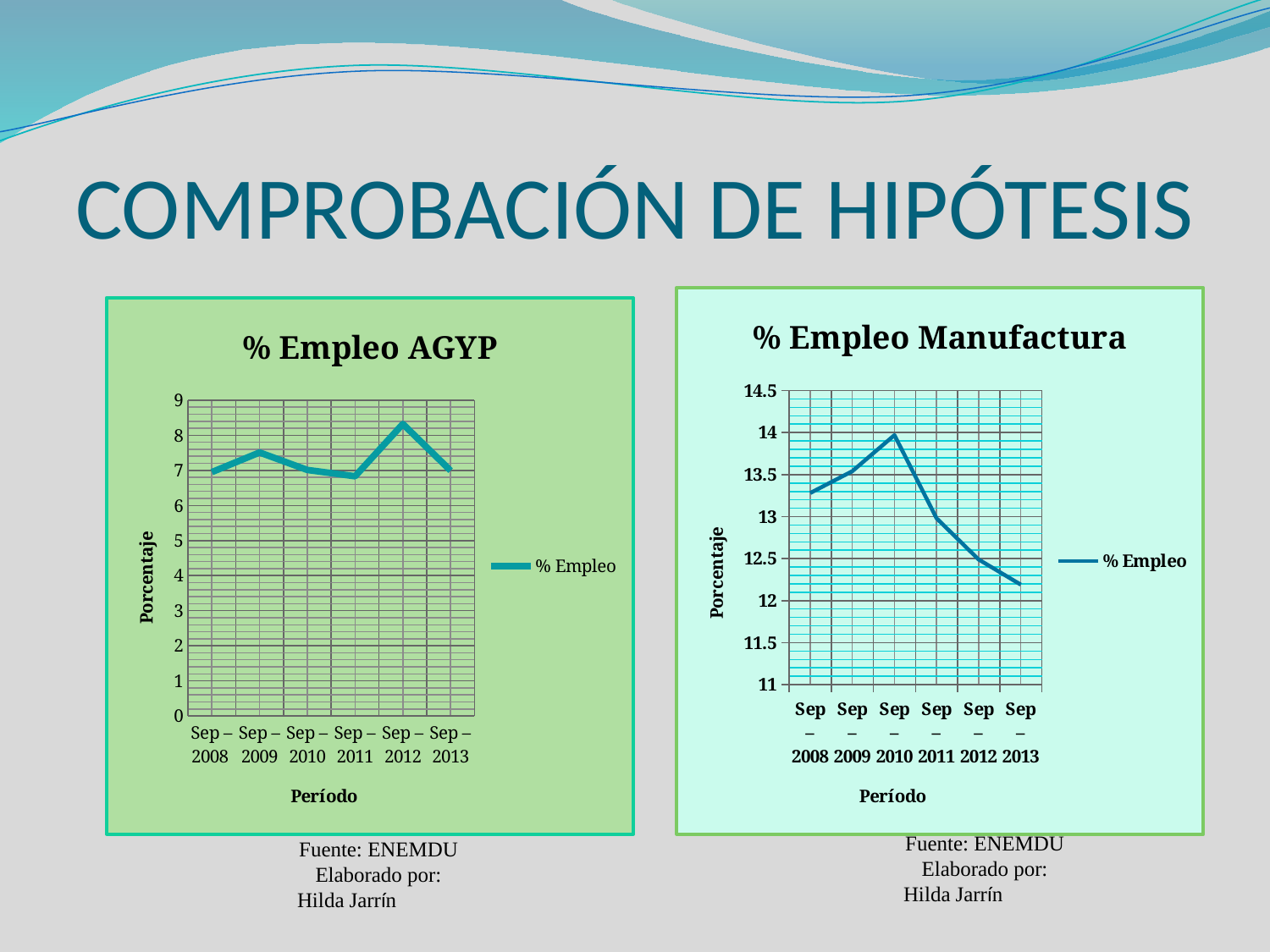
In the "% Empleo AGYP" chart, is the value for Sep – 2012 greater or less than 8? greater In the "% Empleo Manufactura" chart, which period has the lowest value? Sep – 2013 In the "% Empleo Manufactura" chart, which period has the highest value? Sep – 2010 In the "% Empleo Manufactura" chart, is the value for Sep – 2013 greater or less than 12.5? less How many series does the legend of the "% Empleo AGYP" chart list? 1 In the "% Empleo AGYP" chart, is the value for Sep – 2009 greater or less than 7? greater What kind of chart is the "% Empleo AGYP" chart? line chart How many periods are plotted on the x axis of the "% Empleo Manufactura" chart? 6 In the "% Empleo Manufactura" chart, do the values rise or fall from Sep – 2010 to Sep – 2013? fall In the "% Empleo Manufactura" chart, which is larger, the value for Sep – 2008 or Sep – 2013? Sep – 2008 What is the label of the y axis on the "% Empleo Manufactura" chart? Porcentaje In the "% Empleo AGYP" chart, which period has the highest value? Sep – 2012